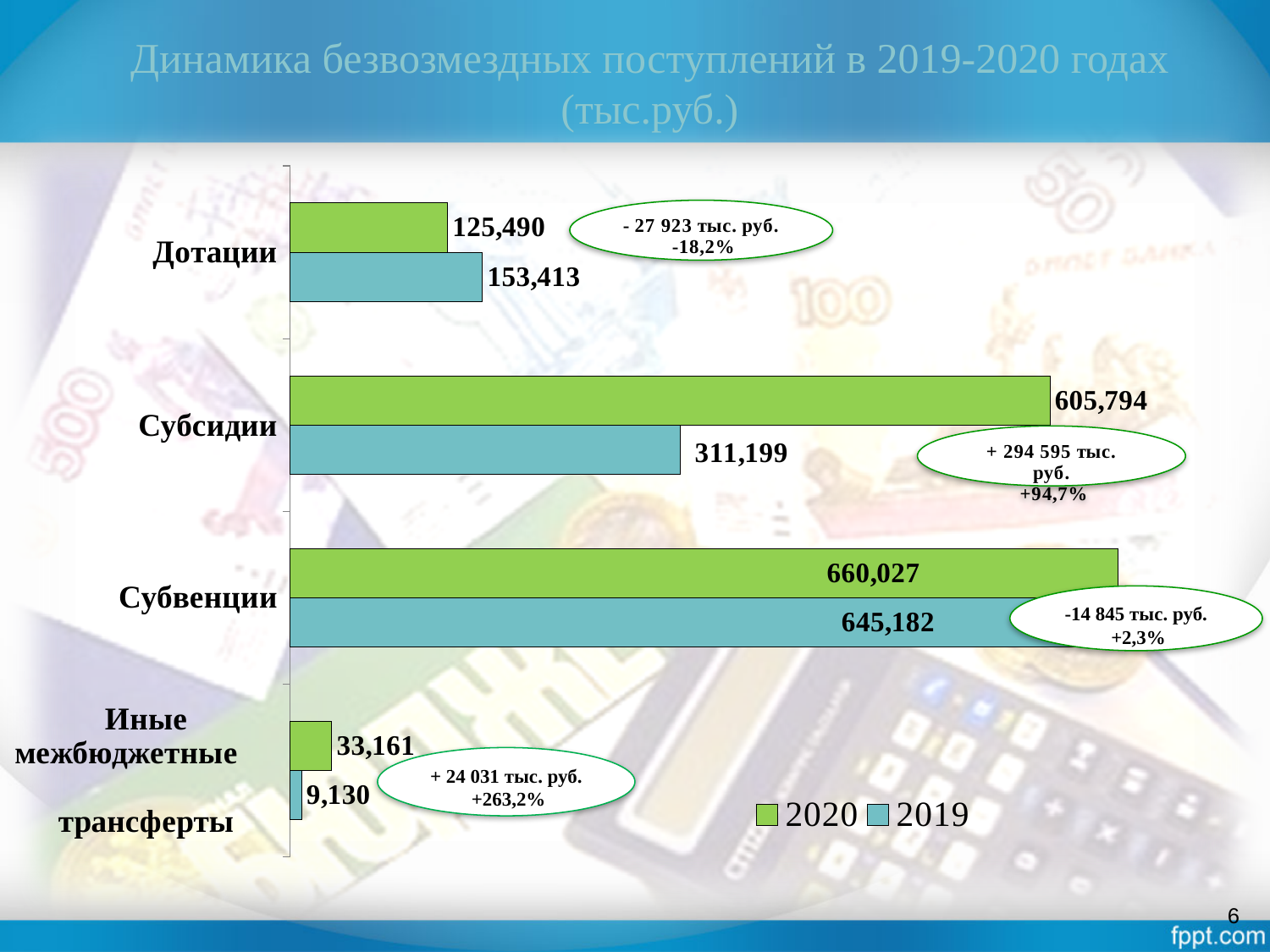
What is the 2019 value for Субсидии? 311,199 Which is larger for Дотации, the 2020 value or the 2019 value? 2019 What is the 2020 value for Дотации? 125,490 Which category has the highest 2020 value? Субвенции How many categories are shown on the chart? 4 How many series does the legend list? 2 What is the difference between the 2020 and 2019 values for Субсидии? 294,595 What is the 2019 value for Субвенции? 645,182 What type of chart is shown on the slide? Bar chart Which colour represents the 2020 series in the legend? Green What is the 2020 value for Иные межбюджетные трансферты? 33,161 Which category has the lowest 2019 value? Иные межбюджетные трансферты